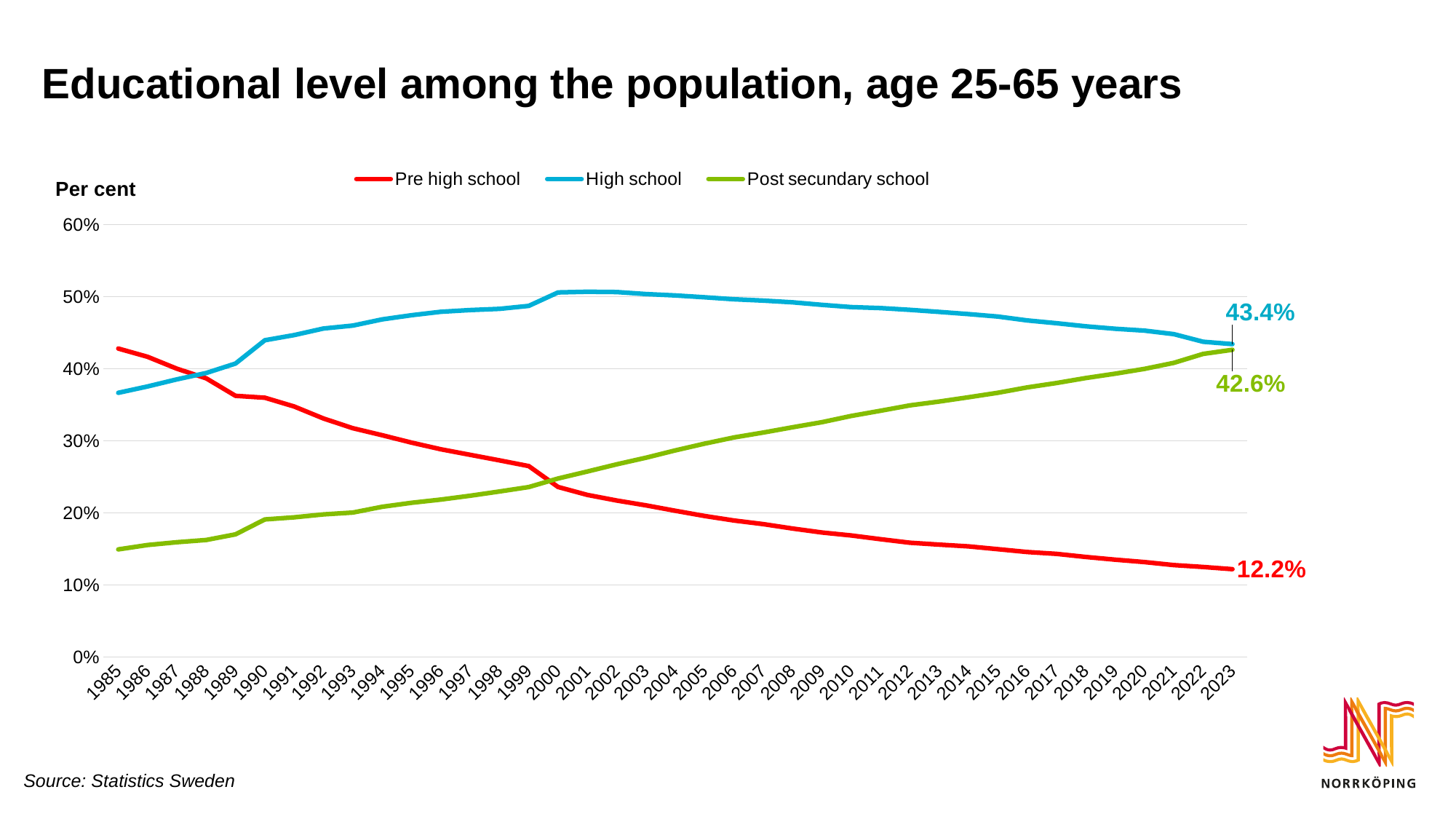
What is the value for High school in 2023? 43.4% Does the Pre high school series rise or fall from 1985 to 2023? Fall What kind of chart is shown on the slide? Line chart What is the value for Pre high school in 2023? 12.2% Is the value for Pre high school in 1985 greater or less than 40%? greater Is the value for Post secundary school in 1985 greater or less than 20%? less What is the source cited for the chart? Statistics Sweden What is the value for Post secundary school in 2023? 42.6% What is the difference between the High school and Post secundary school values in 2023? 0.8 percentage points In 2023, which is larger: High school or Post secundary school? High school How many series does the legend list? 3 Which series has the lowest value in 2023? Pre high school